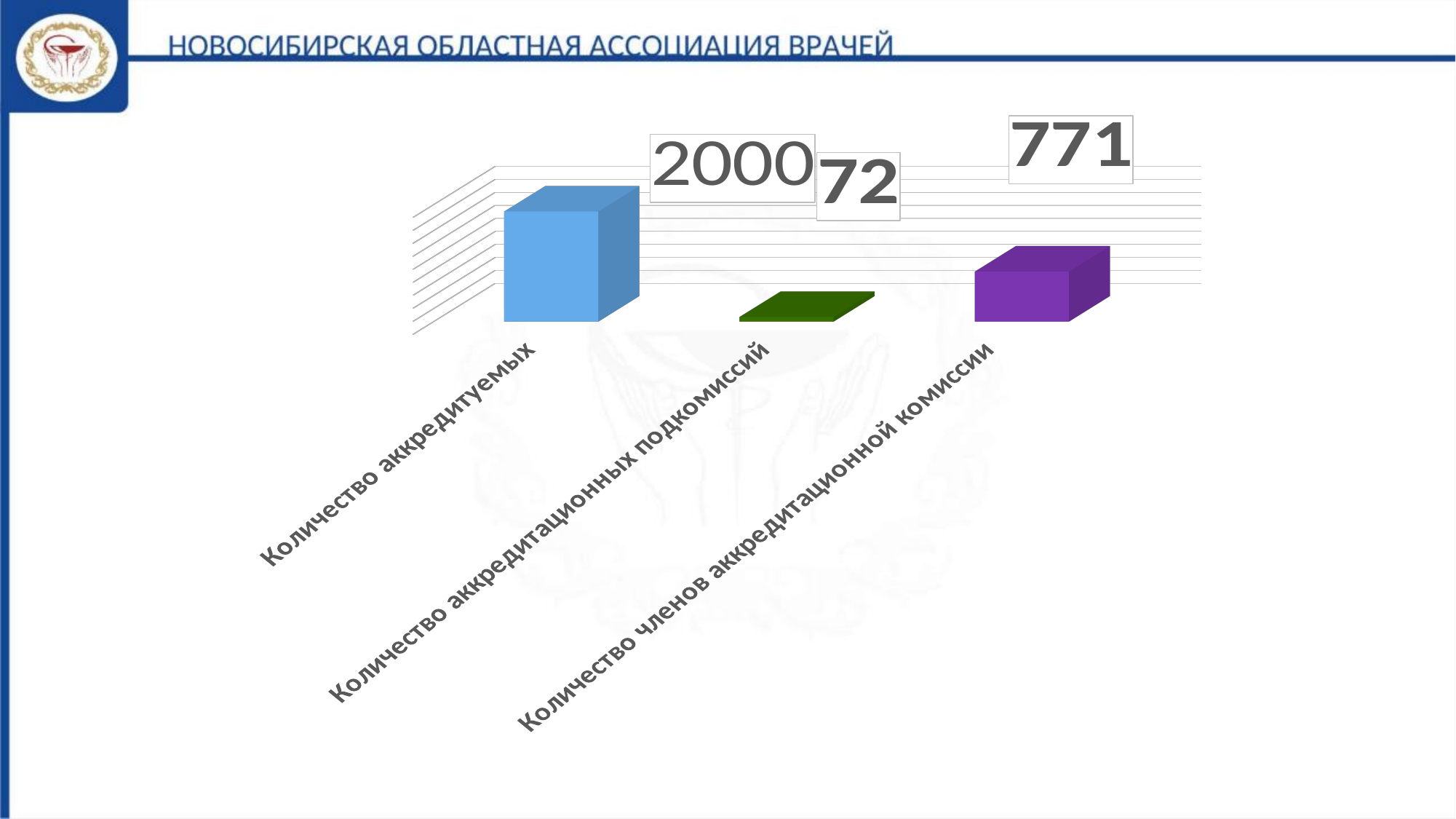
Which category has the lowest value? Количество аккредитационных подкомиссий How many categories are shown in the chart? 3 Which category has the highest value? Количество аккредитуемых What colour is the bar for Количество аккредитуемых? blue Which is larger: the value for Количество членов аккредитационной комиссии or the value for Количество аккредитационных подкомиссий? Количество членов аккредитационной комиссии What kind of chart is shown on the slide? bar chart What is the difference between the value for Количество аккредитуемых and the value for Количество членов аккредитационной комиссии? 1229 What is the value for Количество членов аккредитационной комиссии? 771 What is the value for Количество аккредитуемых? 2000 What is the value for Количество аккредитационных подкомиссий? 72 What colour is the bar for Количество членов аккредитационной комиссии? purple What is the difference between the value for Количество членов аккредитационной комиссии and the value for Количество аккредитационных подкомиссий? 699